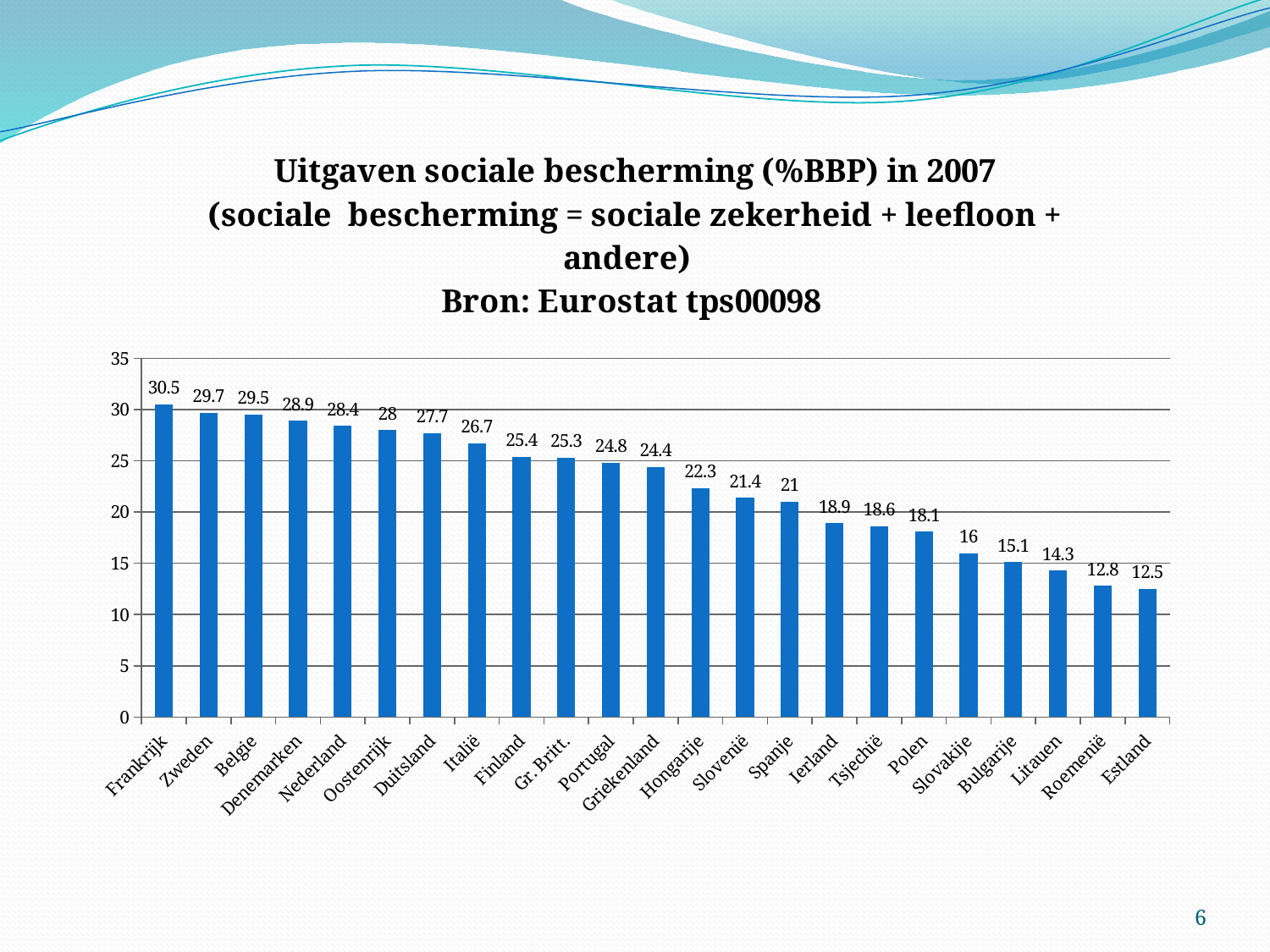
Do the values rise or fall from left to right along the x axis? Fall Is the value for Duitsland greater or less than 25? greater What kind of chart is shown on the slide? Bar chart How many countries are shown in the chart? 23 Which country has the highest value? Frankrijk What is the value for Hongarije? 22.3 What is the difference between the values for Frankrijk and Estland? 18 Which country has the lowest value? Estland What is the value for Slovakije? 16 Which has a larger value, Portugal or Ierland? Portugal What is the difference between the values for Nederland and Spanje? 7.4 What is the value for Belgie? 29.5